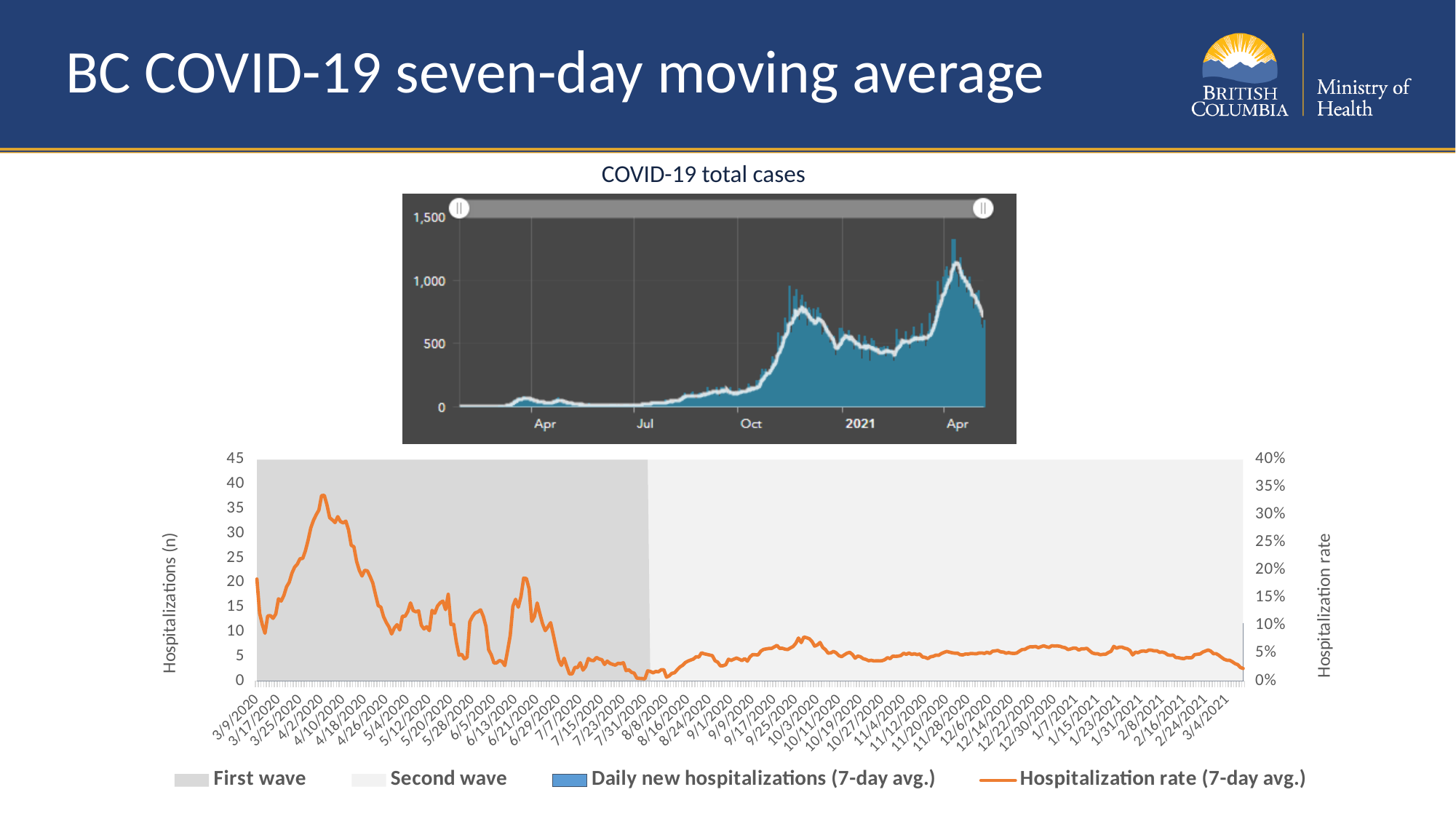
In the top chart (COVID-19 total cases), what is the highest value shown on the y axis? 1,500 In the bottom chart, is the peak of the Hospitalization rate (7-day avg.) line in the first wave greater or less than 25%? greater How many entries does the legend of the bottom chart list? 4 In the bottom chart, which wave shows the higher peak of the Hospitalization rate (7-day avg.) line, the first wave or the second wave? First wave In the bottom chart, is the Hospitalization rate (7-day avg.) at 3/4/2021 greater or less than 5%? less In the bottom chart, does the Hospitalization rate (7-day avg.) line rise or fall between 4/2/2020 and 7/31/2020? fall What is the label of the left y axis of the bottom chart? Hospitalizations (n) In the top chart (COVID-19 total cases), is the value around Jul 2020 greater or less than 500? less What is the title of the top chart on the slide? COVID-19 total cases What kind of chart is the bottom chart showing the hospitalization rate? line chart